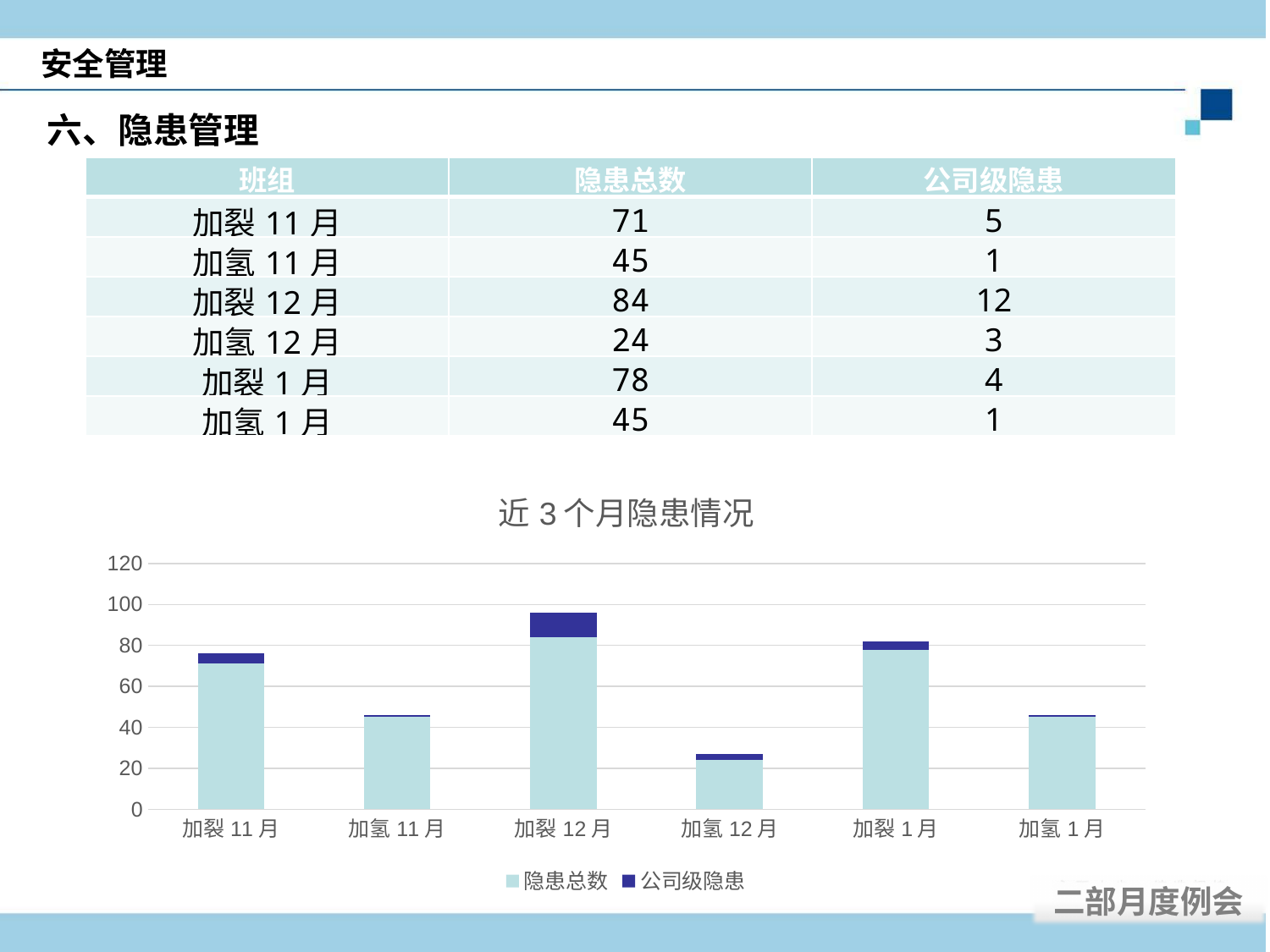
How many series does the chart legend list? 2 How many categories are shown on the x axis of the chart? 6 Is the 隐患总数 value for 加氢12月 greater or less than 40? less According to the slide, what is the 隐患总数 value for 加裂1月? 78 Which category has the tallest stacked bar in the chart? 加裂12月 According to the slide, what is the 公司级隐患 value for 加裂12月? 12 What kind of chart is shown under the title 近3个月隐患情况? stacked bar chart Which category has the shortest stacked bar in the chart? 加氢12月 What is the title of the chart? 近3个月隐患情况 Is the 隐患总数 value for 加裂12月 greater or less than 80? greater Which is larger, the 隐患总数 bar for 加裂11月 or for 加氢11月? 加裂11月 What is the total height of the stacked bar for 加裂12月 (隐患总数 plus 公司级隐患)? 96